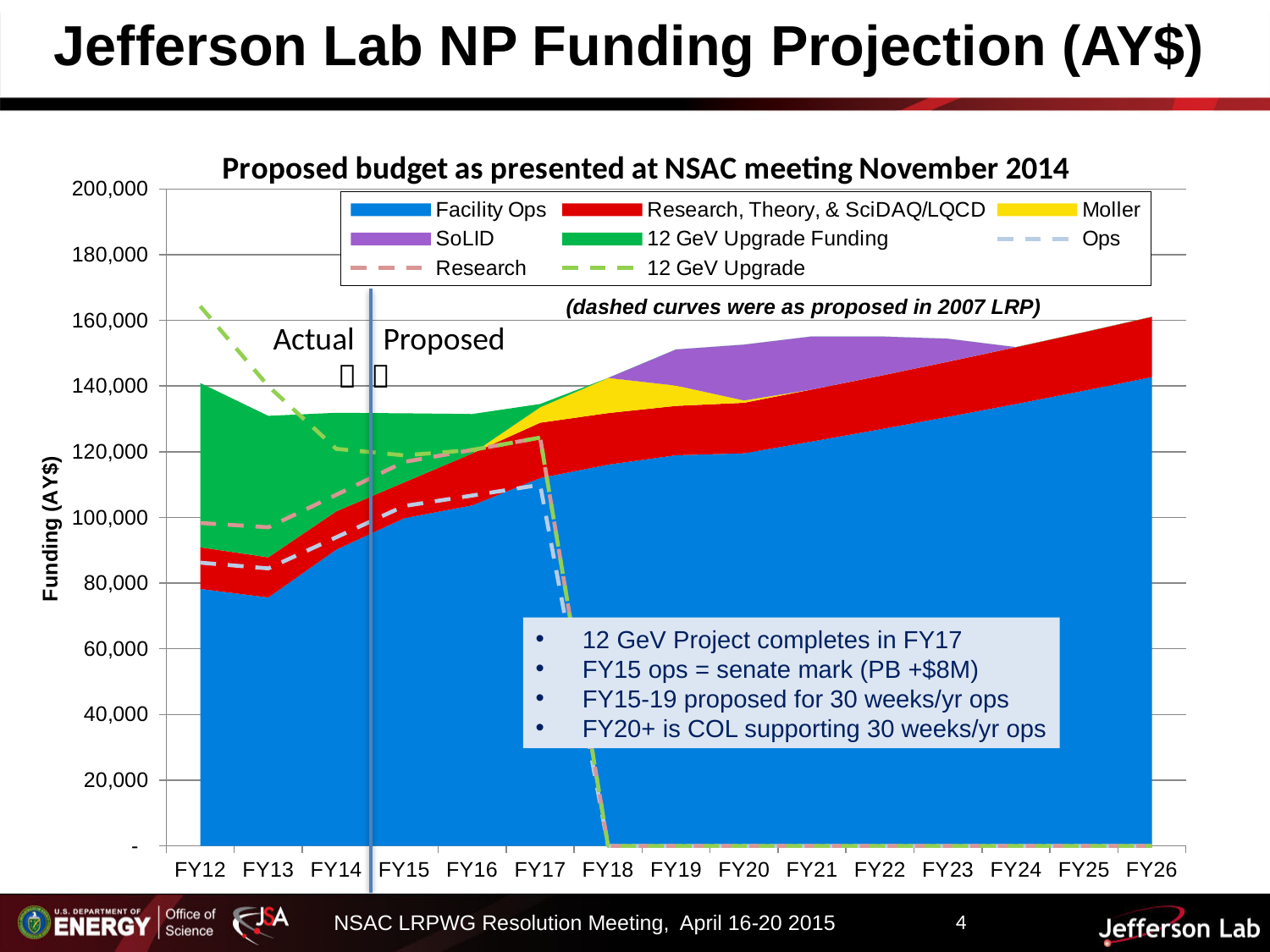
Is the Facility Ops value for FY26 greater or less than 140,000? greater Is the Facility Ops value for FY13 greater or less than 80,000? less Does the Facility Ops series rise or fall from FY14 to FY26? rise Which fiscal year has the highest total stacked funding? FY26 Is the total stacked funding for FY26 greater or less than 140,000? greater What kind of chart is shown on the slide? Area chart How many fiscal years are shown along the x axis? 15 What is the label on the y axis? Funding (AY$) How many series does the legend list? 8 What is the title of the chart? Proposed budget as presented at NSAC meeting November 2014